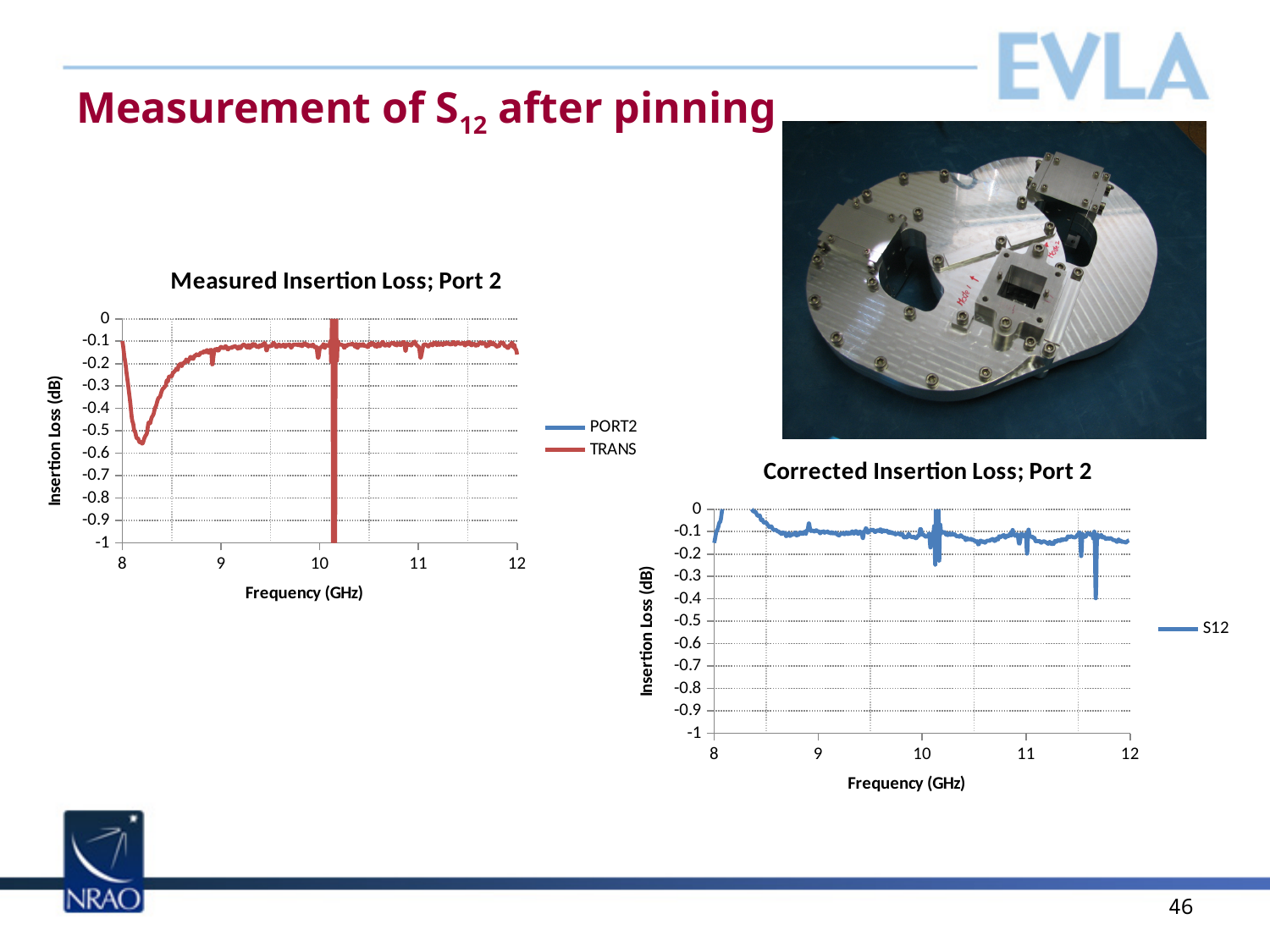
How many series does the legend of the "Measured Insertion Loss; Port 2" chart list? 2 In the "Corrected Insertion Loss; Port 2" chart, is the S12 value at 10 GHz greater or less than -0.5? greater What kind of chart is the "Corrected Insertion Loss; Port 2" chart? line chart In the "Corrected Insertion Loss; Port 2" chart, is the S12 value at 9 GHz greater or less than -0.3? greater In the "Measured Insertion Loss; Port 2" chart, what are the two legend entries? PORT2 and TRANS In the "Measured Insertion Loss; Port 2" chart, does the TRANS line rise or fall between 8 GHz and 8.2 GHz? fall In the "Measured Insertion Loss; Port 2" chart, does the TRANS line rise or fall between 8.5 GHz and 9 GHz? rise How many series does the legend of the "Corrected Insertion Loss; Port 2" chart list? 1 In the "Corrected Insertion Loss; Port 2" chart, what is the label of the x axis? Frequency (GHz) In the "Measured Insertion Loss; Port 2" chart, is the TRANS value at 9 GHz greater or less than -0.5? greater What kind of chart is the "Measured Insertion Loss; Port 2" chart? line chart